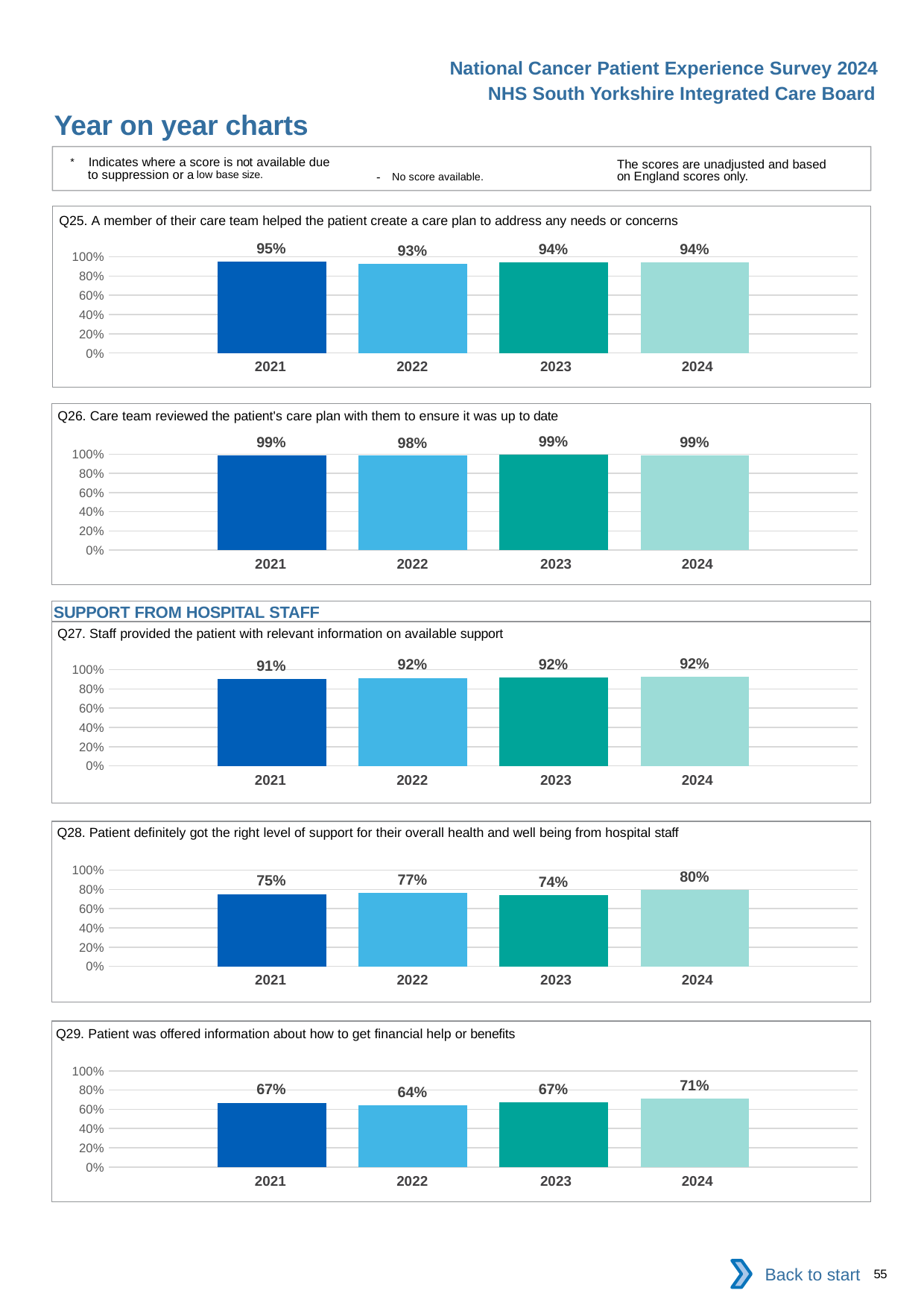
In the Q29 chart, which is larger, the value for 2024 or the value for 2021? 2024 In the Q27 chart, what is the value for 2024? 92% How many years are shown in the Q25 chart? 4 In the Q25 chart, what is the difference between the 2021 value and the 2022 value? 2% In the Q26 chart, which year has the lowest value? 2022 In the Q29 chart, what is the value for 2022? 64% In the Q25 chart, what is the value for 2021? 95% In the Q28 chart, what is the difference between the 2024 value and the 2023 value? 6% What kind of chart is the Q28 chart? bar chart In the Q28 chart, which year has the highest value? 2024 In the Q29 chart, is the value for 2024 greater or less than 80%? less What is the section heading shown above the Q27 chart? SUPPORT FROM HOSPITAL STAFF